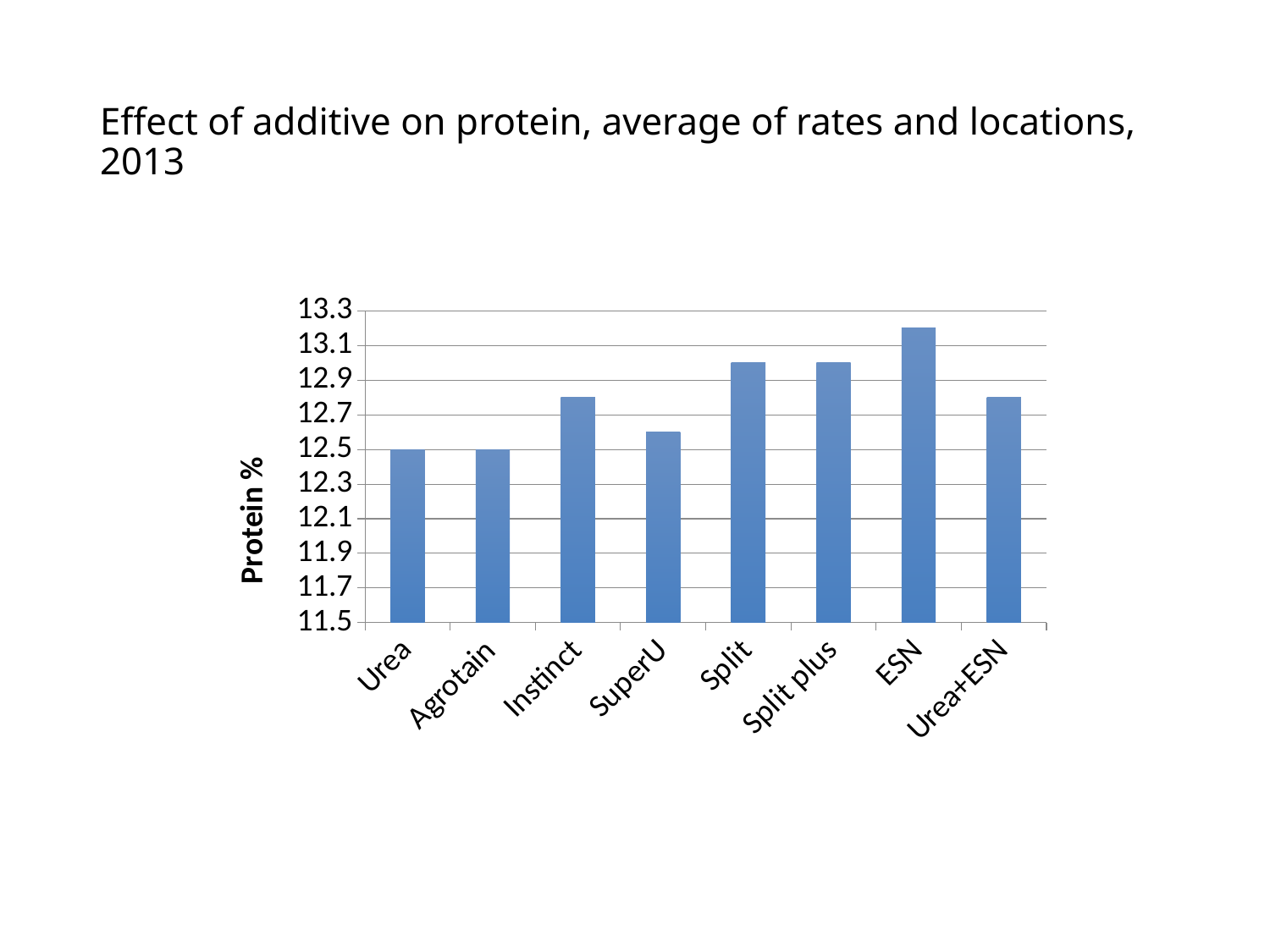
What is the protein % value for Urea? 12.5 What type of chart is shown on the slide? Bar chart Which has a higher protein %, ESN or Split? ESN Which additive has the highest protein %? ESN What is the label on the vertical axis? Protein % How many additive categories are shown on the x axis? 8 Is the value for ESN greater or less than 13.1? greater Which has a higher protein %, Instinct or SuperU? Instinct Is the value for SuperU greater or less than 12.7? less Is the value for Split greater or less than 12.9? greater What is the protein % value for Agrotain? 12.5